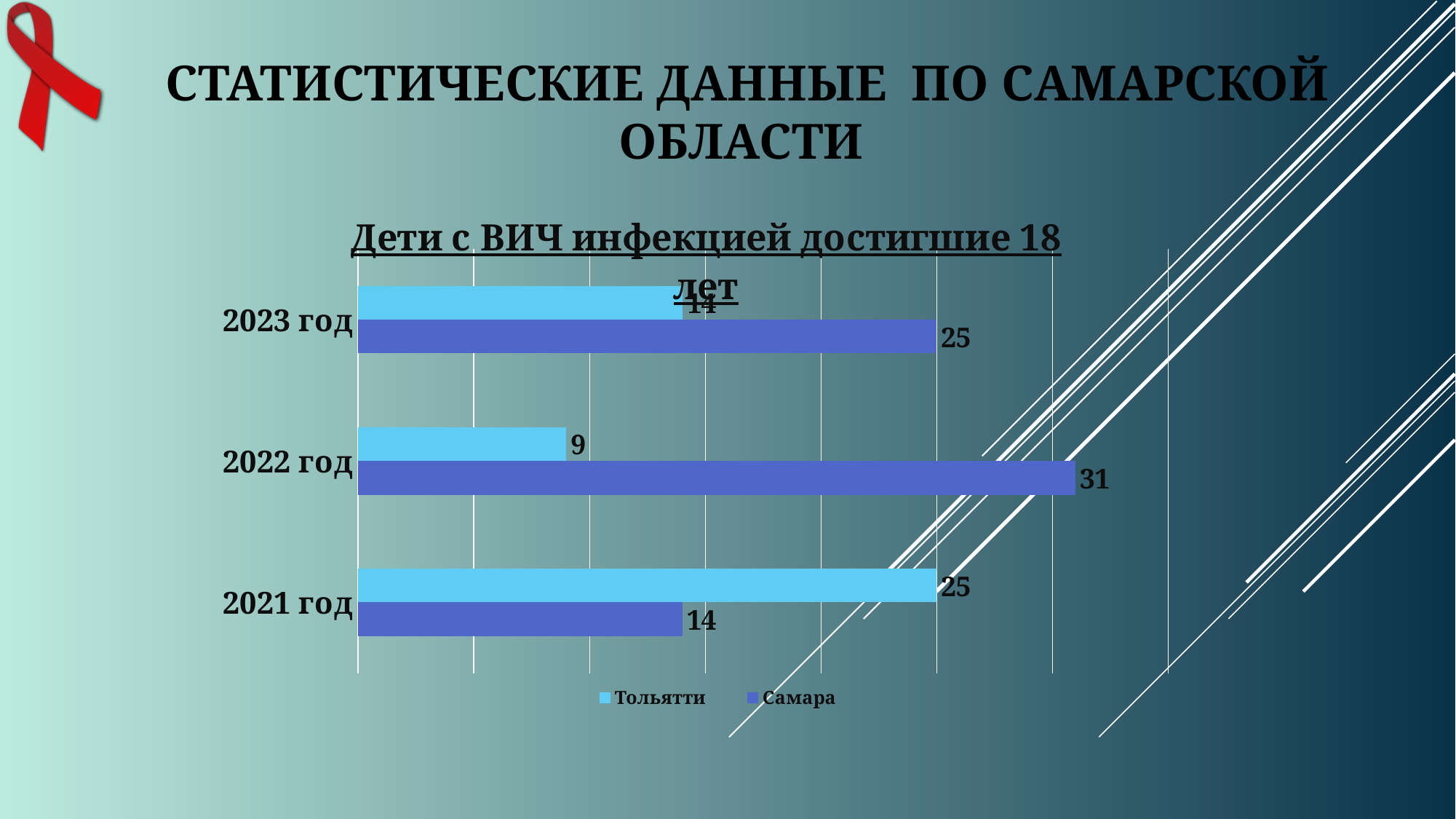
What is the difference between the Самара and Тольятти values in 2023 год? 11 What is the value for Тольятти in 2023 год? 14 How many series does the legend list? 2 In which year is the value for Самара highest? 2022 год What kind of chart is shown on the slide? Bar chart How many years are shown on the chart? 3 In which year is the value for Тольятти lowest? 2022 год What is the value for Самара in 2022 год? 31 What is the value for Тольятти in 2021 год? 25 What is the value for Самара in 2021 год? 14 What is the difference between the Самара and Тольятти values in 2022 год? 22 Which is larger in 2021 год, Тольятти or Самара? Тольятти